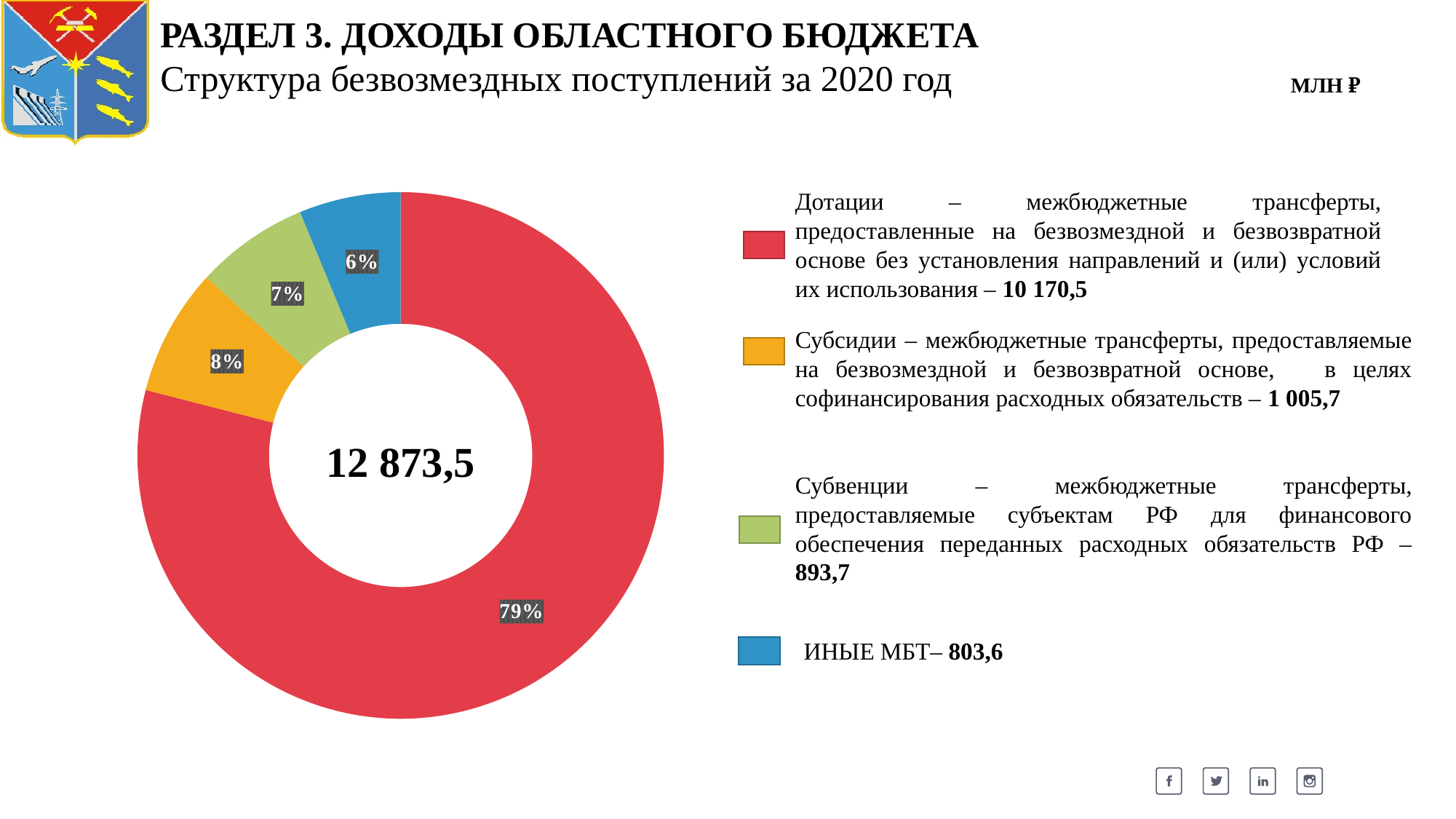
What share of the pie does the Дотации slice (red) represent? 79% What is the difference between the value for Дотации and the value for Субсидии, in млн ₽? 9 164,8 What share of the pie does the Субвенции slice (green) represent? 7% Which category has the largest slice of the pie? Дотации What share of the pie does the Субсидии slice (orange) represent? 8% What kind of chart is shown on the slide? Pie chart (donut) What total value is shown in the centre of the donut chart? 12 873,5 Which category has the smallest slice of the pie? ИНЫЕ МБТ What is the value for Субвенции, in млн ₽? 893,7 How many slices does the pie chart have? 4 Which is larger, the value for Субсидии or the value for ИНЫЕ МБТ? Субсидии